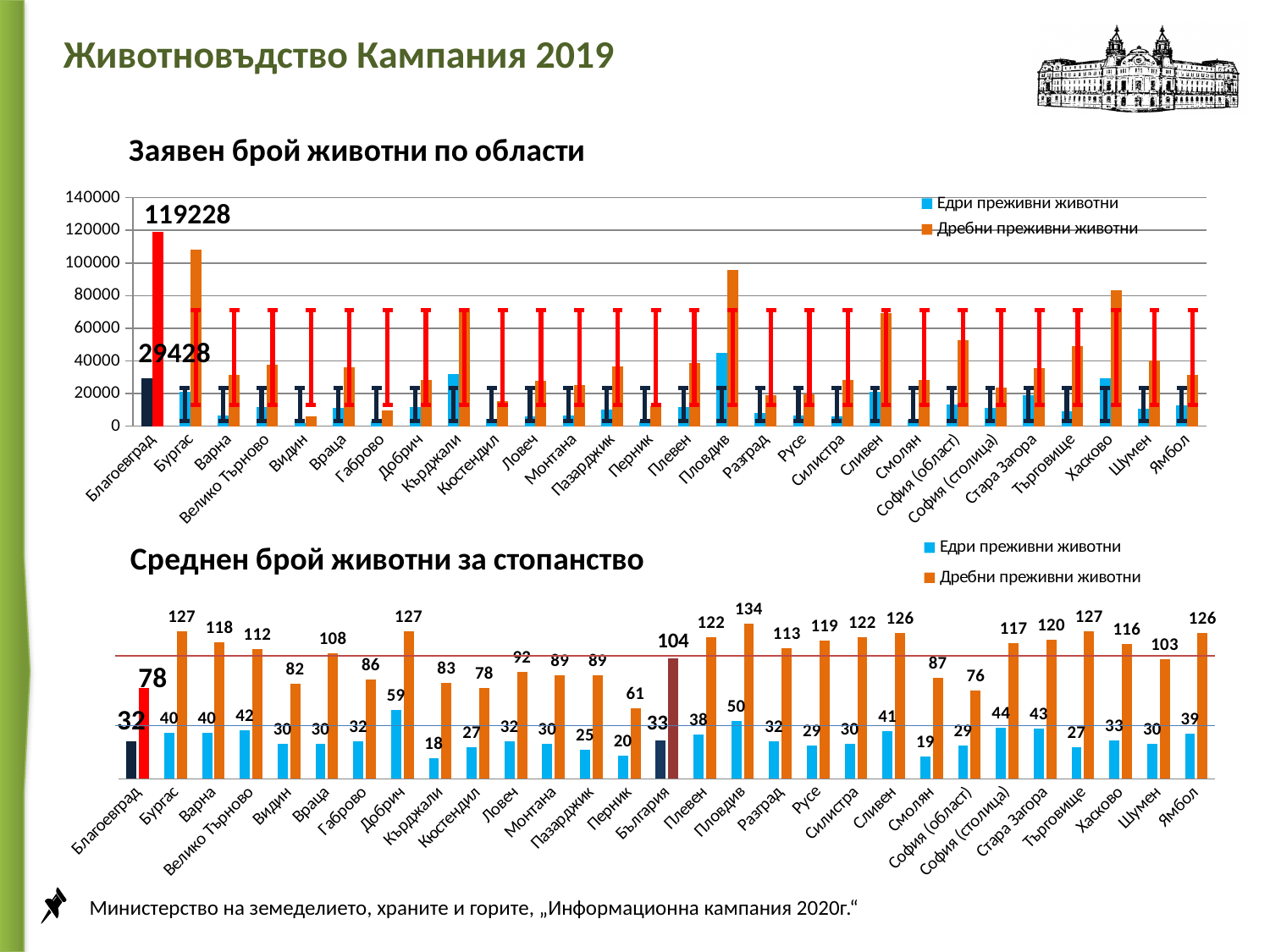
In the bottom chart 'Среднен брой животни за стопанство', what is the value for Дребни преживни животни for България? 104 In the bottom chart 'Среднен брой животни за стопанство', which has the larger Дребни преживни животни value, Бургас or Варна? Бургас In the top chart 'Заявен брой животни по области', what is the value for Едри преживни животни in Благоевград? 29428 How many categories are shown on the x axis of the bottom chart 'Среднен брой животни за стопанство'? 29 In the top chart 'Заявен брой животни по области', is the value for Дребни преживни животни in Бургас greater or less than 100000? greater In the bottom chart 'Среднен брой животни за стопанство', what is the difference between the Дребни преживни животни values for Пловдив and Перник? 73 What kind of chart is the bottom chart 'Среднен брой животни за стопанство'? bar chart How many series does the legend of the top chart 'Заявен брой животни по области' list? 2 In the bottom chart 'Среднен брой животни за стопанство', which region has the lowest value for Едри преживни животни? Кърджали In the top chart 'Заявен брой животни по области', is the value for Дребни преживни животни in Видин greater or less than 20000? less In the bottom chart 'Среднен брой животни за стопанство', which region has the highest value for Дребни преживни животни? Пловдив In the top chart 'Заявен брой животни по области', what is the value for Дребни преживни животни in Благоевград? 119228